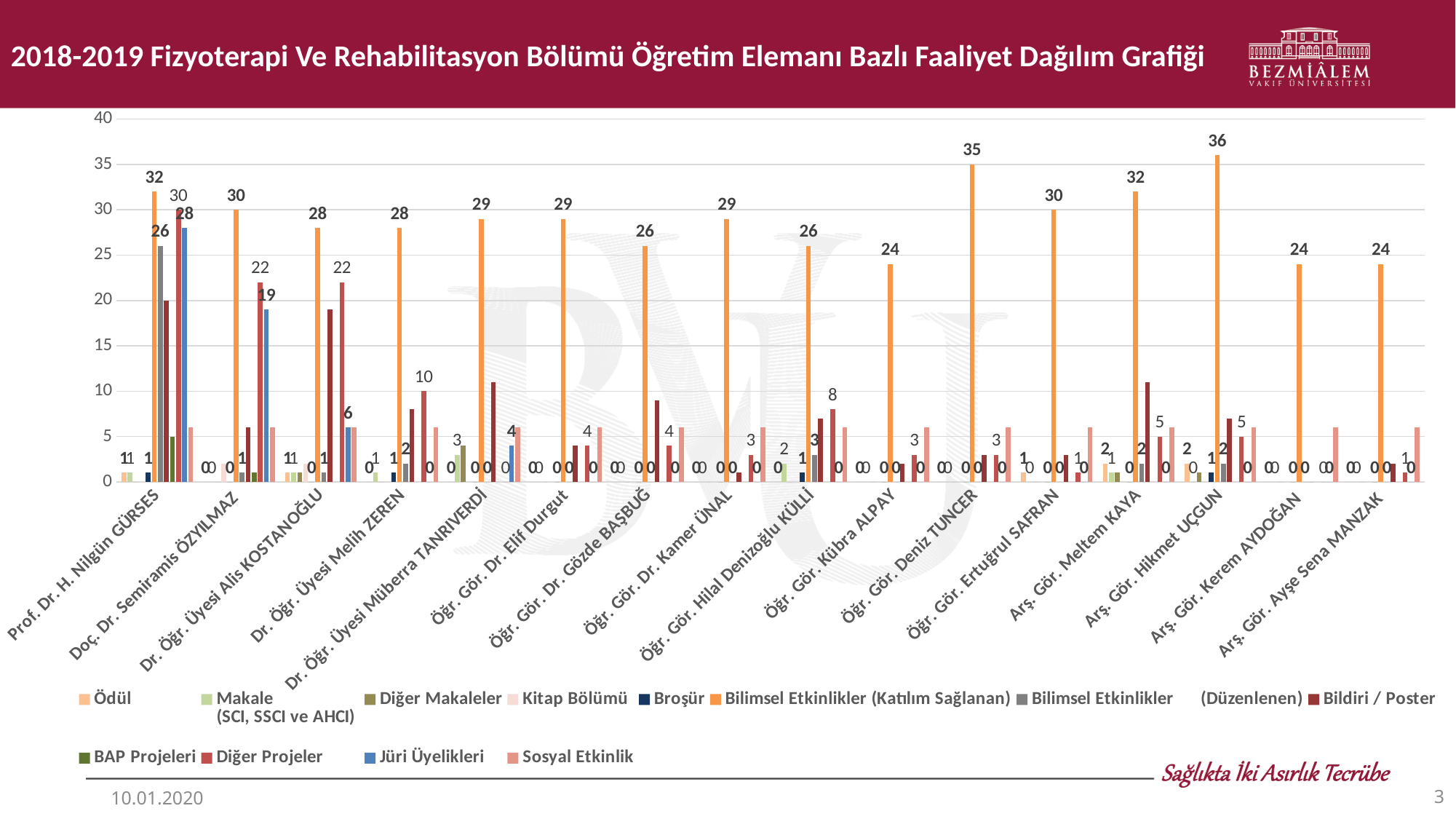
What is the difference between the Bilimsel Etkinlikler (Katılım Sağlanan) values of Arş. Gör. Hikmet UÇGUN and Öğr. Gör. Deniz TUNCER? 1 How many staff members (categories) are shown on the x axis? 16 What is the Bilimsel Etkinlikler (Katılım Sağlanan) value for Öğr. Gör. Deniz TUNCER? 35 Is the Bildiri / Poster value for Prof. Dr. H. Nilgün GÜRSES greater or less than 15? greater What is the Diğer Projeler value for Dr. Öğr. Üyesi Melih ZEREN? 10 Which staff member has the highest value for Bilimsel Etkinlikler (Katılım Sağlanan)? Arş. Gör. Hikmet UÇGUN What is the Jüri Üyelikleri value for Prof. Dr. H. Nilgün GÜRSES? 28 How many series does the legend list? 12 What kind of chart is shown on the slide? bar chart What is the Jüri Üyelikleri value for Doç. Dr. Semiramis ÖZYILMAZ? 19 Who has the larger Diğer Projeler value, Prof. Dr. H. Nilgün GÜRSES or Doç. Dr. Semiramis ÖZYILMAZ? Prof. Dr. H. Nilgün GÜRSES What is the title of the chart? 2018-2019 Fizyoterapi Ve Rehabilitasyon Bölümü Öğretim Elemanı Bazlı Faaliyet Dağılım Grafiği